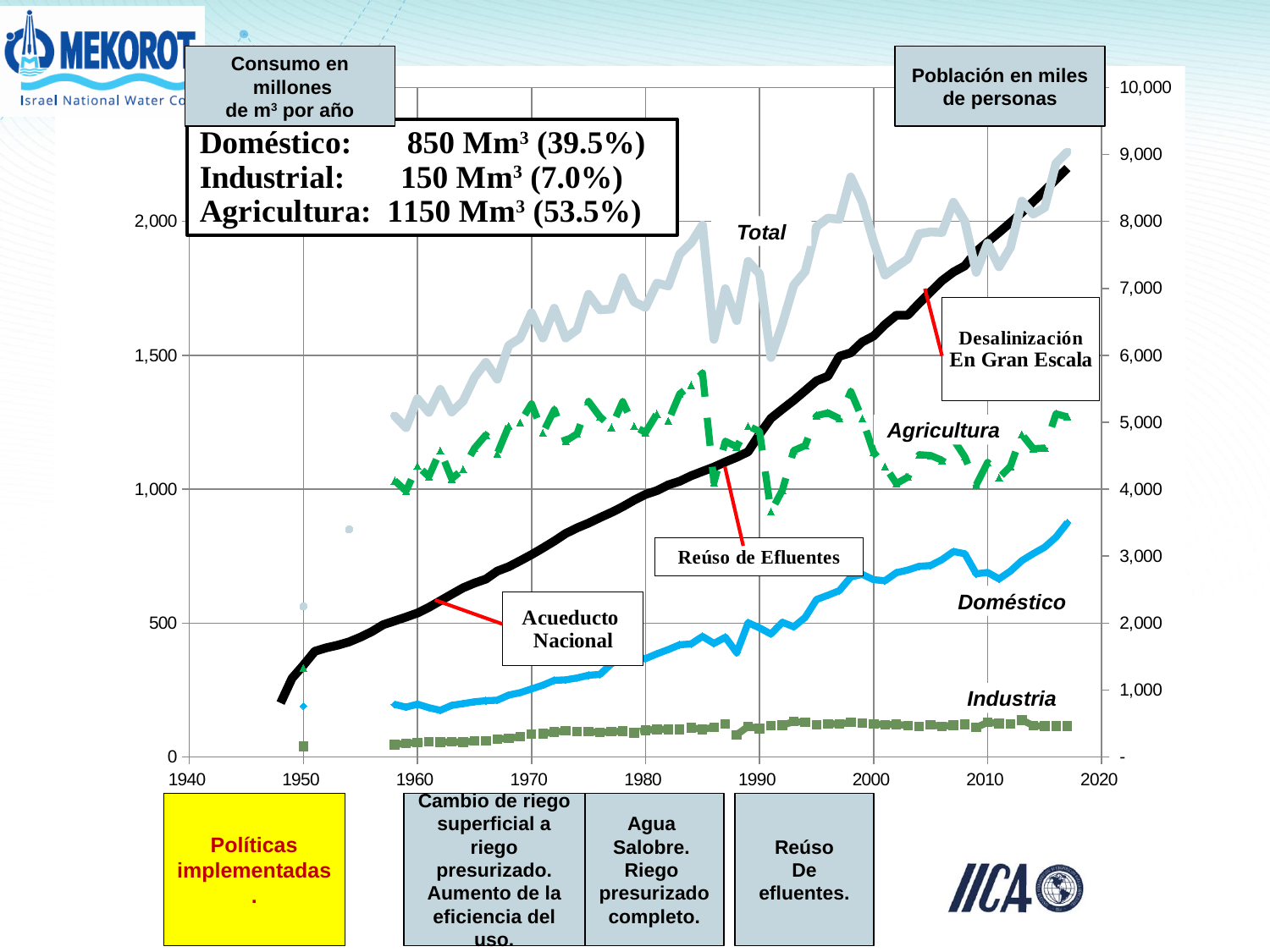
Of the three sectors listed in the text box (Doméstico, Industrial, Agricultura), which has the lowest consumption? Industrial According to the text box on the chart, what is the consumption for Industrial? 150 Mm³ (7.0%) Is the Industria line greater or less than 500 on the left axis throughout the chart? less What does the right-hand axis of the chart represent? Población en miles de personas Using the values in the text box, how much larger is Agricultura consumption than Doméstico consumption? 300 Mm³ According to the text box on the chart, what is the consumption for Doméstico? 850 Mm³ (39.5%) Does the Doméstico line generally rise or fall from 1960 to 2017? rise What kind of chart is shown on the slide? line chart According to the text box on the chart, what is the consumption for Agricultura? 1150 Mm³ (53.5%) Is the Total line at its last point (around 2017) greater or less than 2,000 on the left axis? greater Using the values in the text box, what is the combined consumption of Doméstico, Industrial and Agricultura? 2150 Mm³ Of the three sectors listed in the text box (Doméstico, Industrial, Agricultura), which has the highest consumption? Agricultura